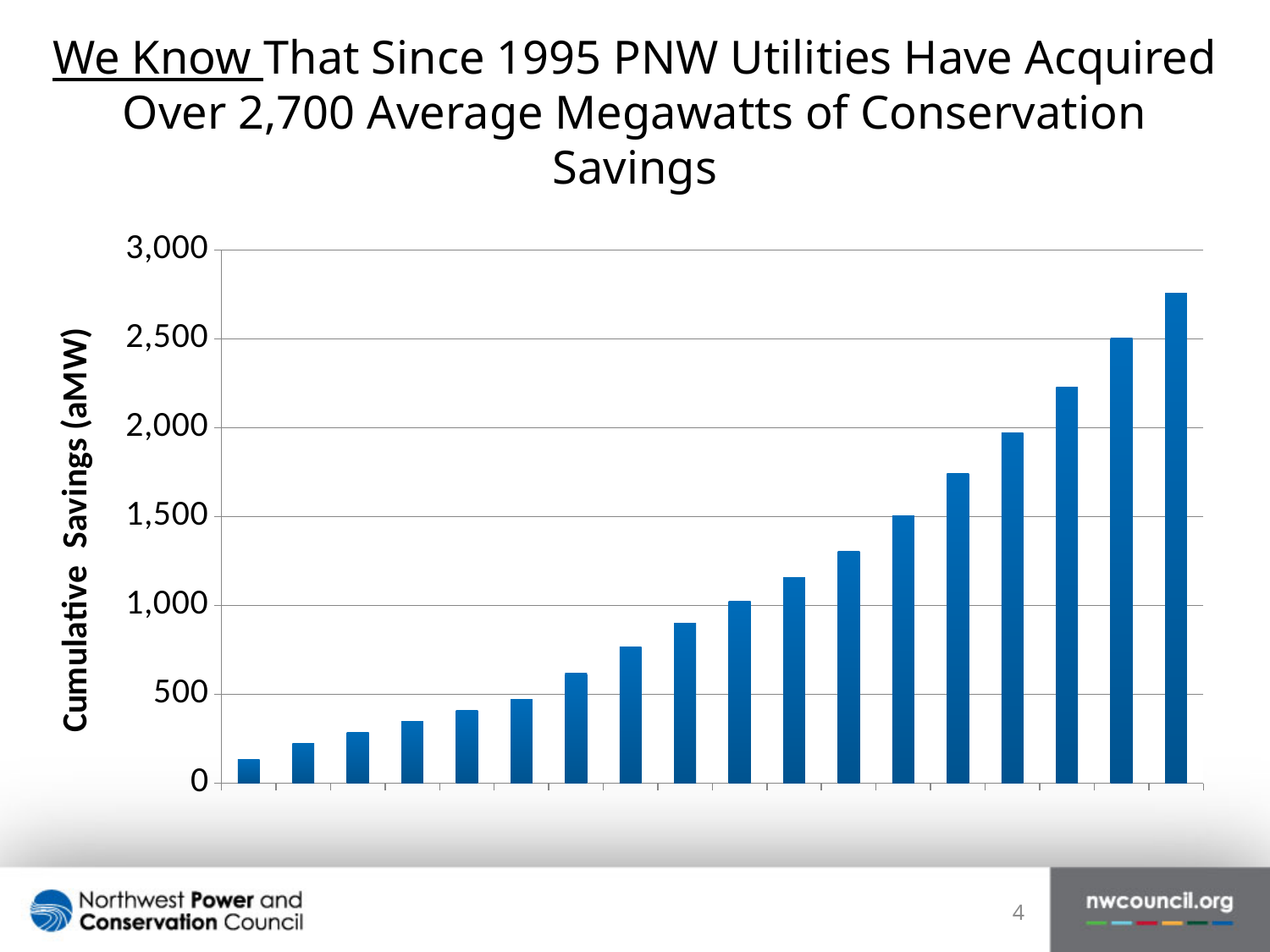
Which bar is the shortest in the chart? the leftmost (first) bar Is the value of the second-from-right bar greater or less than 2,000? greater What is the label on the vertical axis of the chart? Cumulative Savings (aMW) How many bars are plotted in the chart? 18 Is the value of the rightmost bar greater or less than 3,000? less Is the value of the leftmost bar greater or less than 500? less What kind of chart is shown on the slide? bar chart Do the bar values rise or fall from left to right along the x axis? rise Which is larger, the value of the rightmost bar or the value of the leftmost bar? the rightmost bar Which bar is the tallest in the chart? the rightmost (last) bar What is the highest value shown on the vertical axis of the chart? 3,000